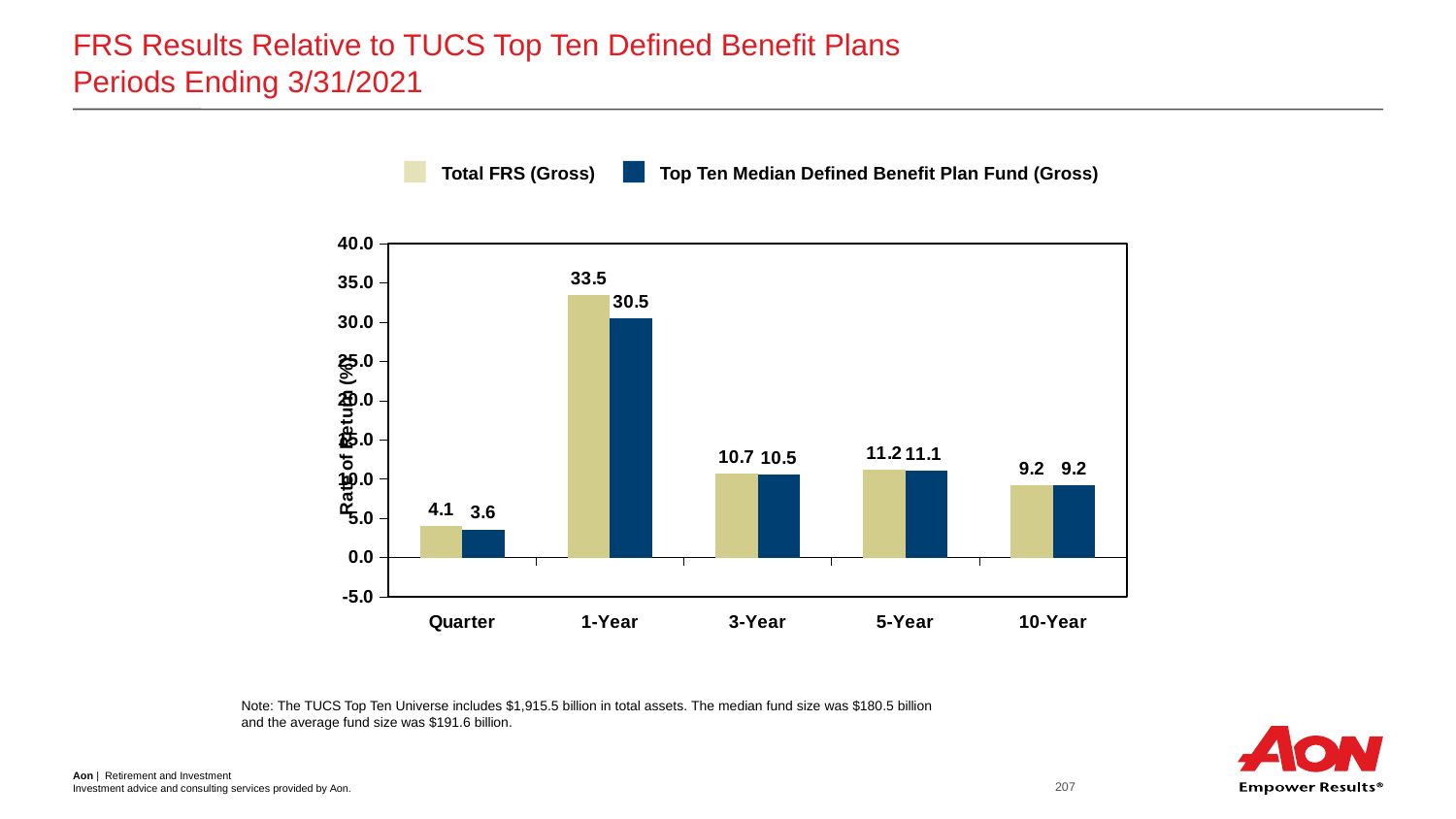
What is the Total FRS (Gross) value for the 1-Year period? 33.5 What is the difference between the Total FRS (Gross) and Top Ten Median Defined Benefit Plan Fund (Gross) values for the 1-Year period? 3.0 What is the Total FRS (Gross) value for the 10-Year period? 9.2 Which period has the highest Total FRS (Gross) value? 1-Year Is the Total FRS (Gross) value for the 5-Year period greater or less than 10.0? greater What is the label of the y axis? Rate of Return (%) How many series does the legend list? 2 Which period has the lowest Top Ten Median Defined Benefit Plan Fund (Gross) value? Quarter For the 3-Year period, which is larger: Total FRS (Gross) or Top Ten Median Defined Benefit Plan Fund (Gross)? Total FRS (Gross) What is the Top Ten Median Defined Benefit Plan Fund (Gross) value for the Quarter period? 3.6 What kind of chart is shown on the slide? Bar chart How many periods are shown on the x axis? 5